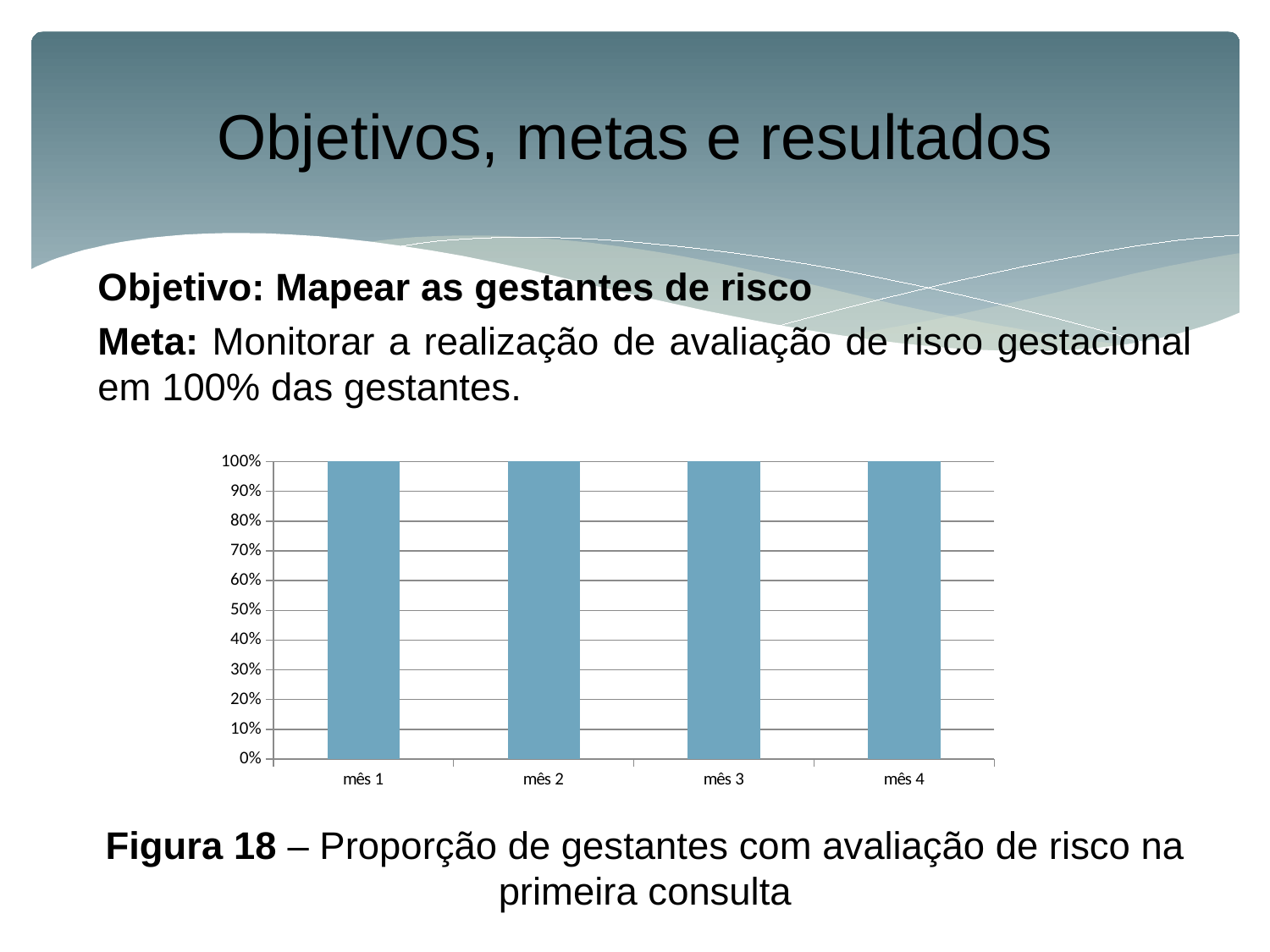
What is the highest value shown on the y axis of the chart? 100% How many categories (months) are shown on the x axis of the chart? 4 What is the value for mês 4 in the chart? 100% What type of chart is shown on the slide? bar chart Do the values rise, fall, or stay the same from mês 1 to mês 4? stay the same Is the value for mês 3 greater or less than 50%? greater What is the difference between the values for mês 1 and mês 4? 0% What is the figure caption below the chart? Figura 18 – Proporção de gestantes com avaliação de risco na primeira consulta What is the value for mês 3 in the chart? 100% What is the value for mês 1 in the chart? 100% What is the value for mês 2 in the chart? 100%